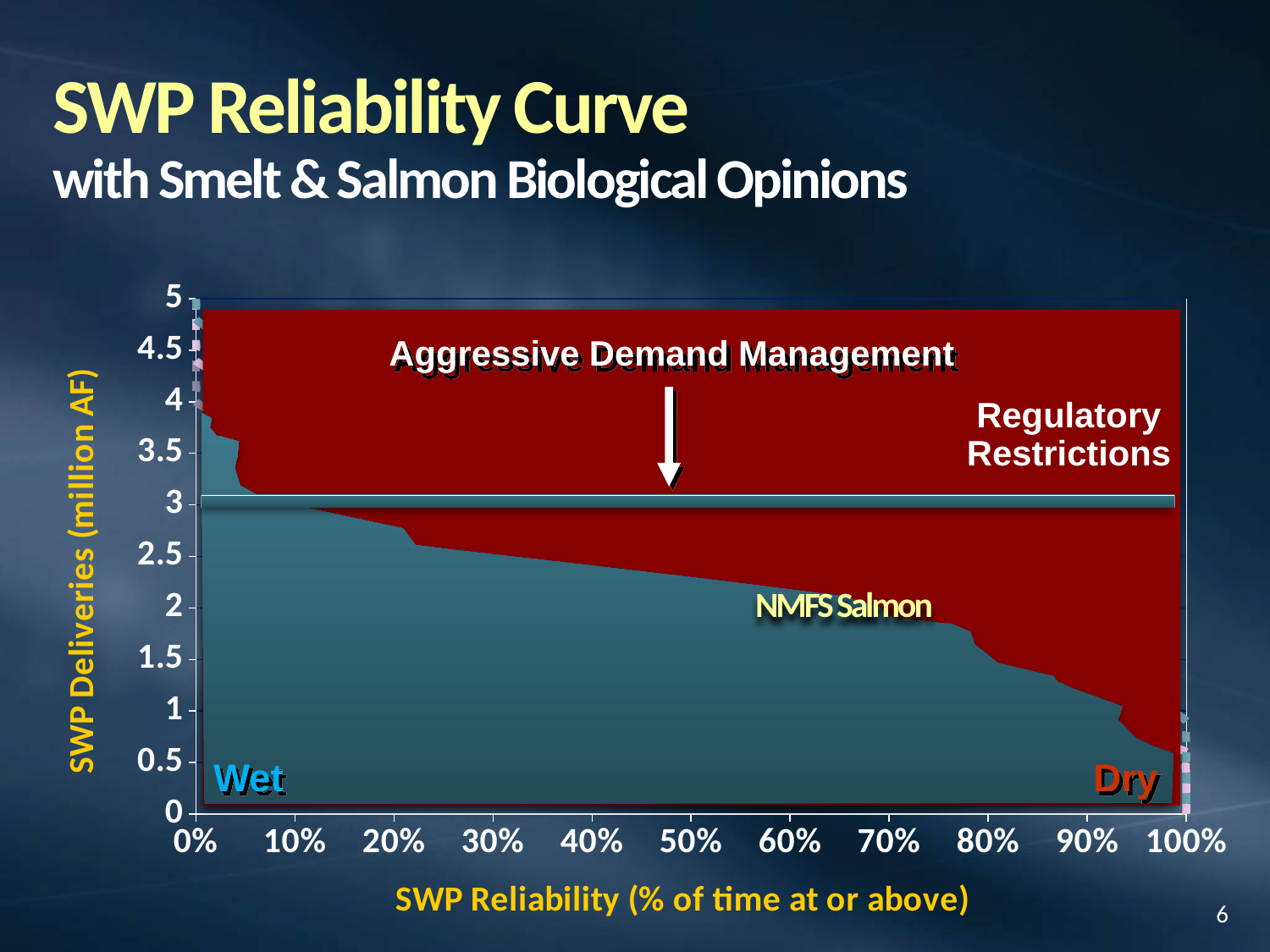
Is the SWP delivery value at 90% reliability greater or less than 1.5 million AF? less Do SWP deliveries rise or fall as SWP reliability increases from 0% to 100%? Fall Is the SWP delivery value at 50% reliability greater or less than 2 million AF? greater Is the SWP delivery value at 100% reliability greater or less than 1 million AF? less What is the label of the y axis? SWP Deliveries (million AF) What is the label of the x axis? SWP Reliability (% of time at or above) What kind of chart is shown on the slide? Area chart How many tick labels are shown on the x axis? 11